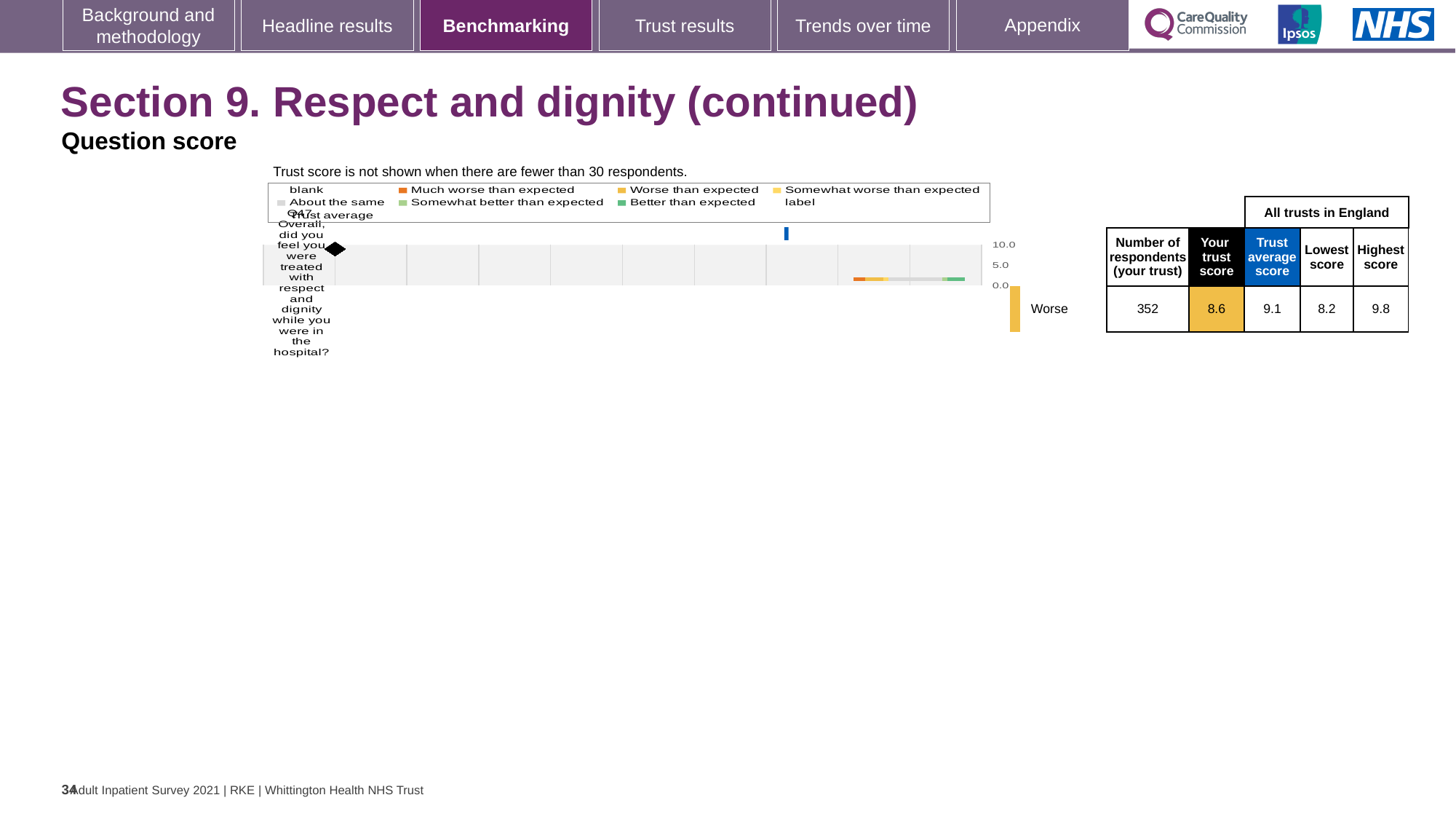
Which is larger for Q47: your trust score or the trust average score? Trust average score What is the lowest score among all trusts in England shown for Q47? 8.2 What is the difference between the highest score and the lowest score shown for Q47? 1.6 What is the 'Trust average score' for all trusts in England shown for Q47? 9.1 What is the difference between the trust average score and your trust score for Q47? 0.5 What is the highest score among all trusts in England shown for Q47? 9.8 What word is printed next to the yellow bar to the right of the chart? Worse What kind of chart is shown on the slide? Bar chart Which question number is plotted on the chart? Q47 What is the 'Your trust score' shown for Q47 on this slide? 8.6 How many respondents from your trust are shown for Q47? 352 Is your trust score for Q47 greater or less than 5.0 on the chart's axis? greater